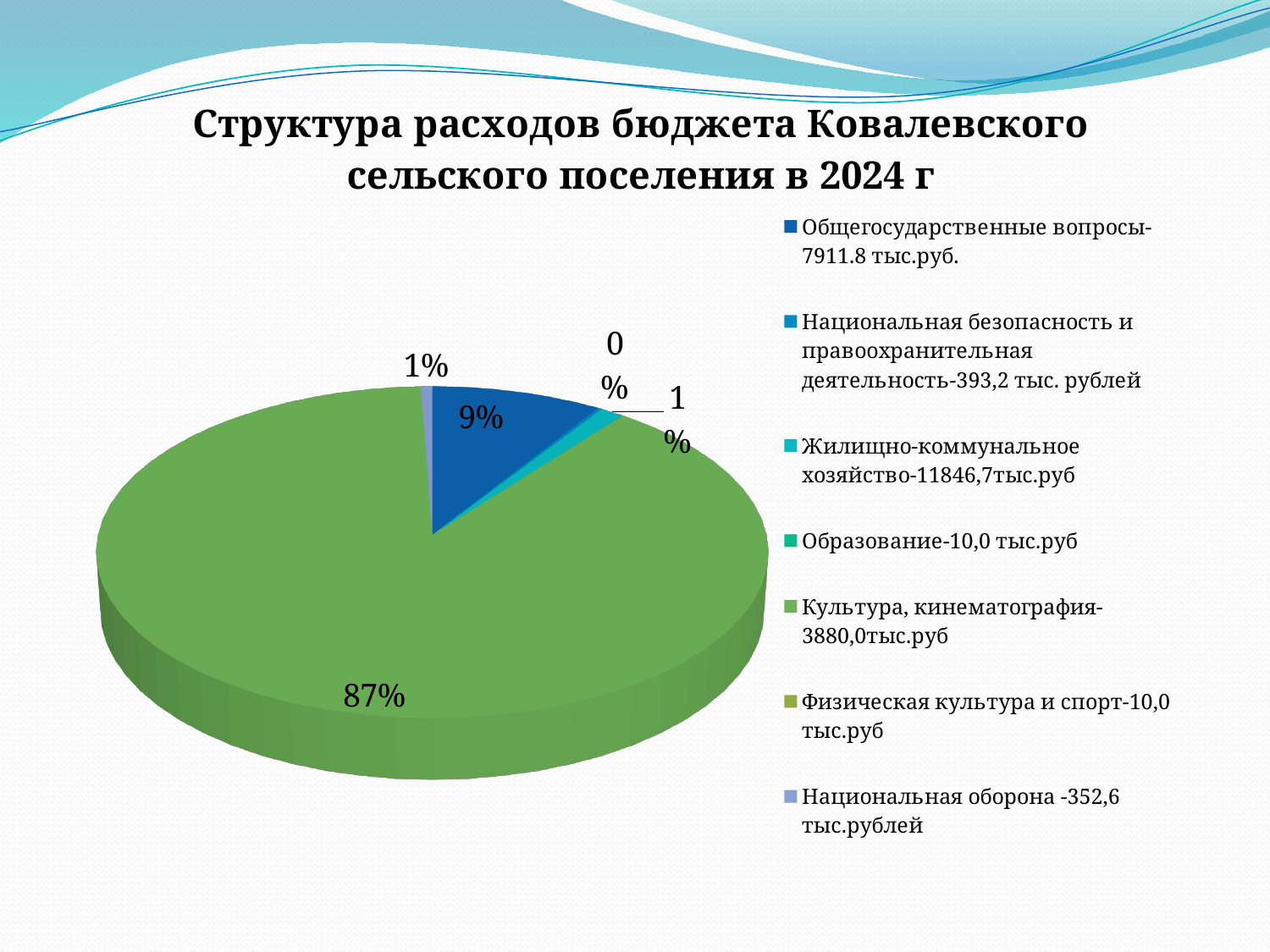
What is the difference in percentage points between the 87% slice and the 9% slice? 78% What amount does the legend give for Жилищно-коммунальное хозяйство? 11846,7тыс.руб Which year does the chart title refer to? 2024 What amount does the legend give for Национальная оборона? 352,6 тыс.рублей What is the largest percentage labelled on the pie chart? 87% Which slice is larger, the green slice labelled 87% or the dark blue slice labelled 9%? the green slice (87%) What kind of chart is shown on the slide? pie chart How many categories does the legend of the pie chart list? 7 How many percentage labels are shown on the pie chart? 5 Is the largest slice of the pie chart greater or less than 50%? greater What percentage is labelled on the dark blue slice of the pie chart? 9% What amount does the legend give for Общегосударственные вопросы? 7911.8 тыс.руб.